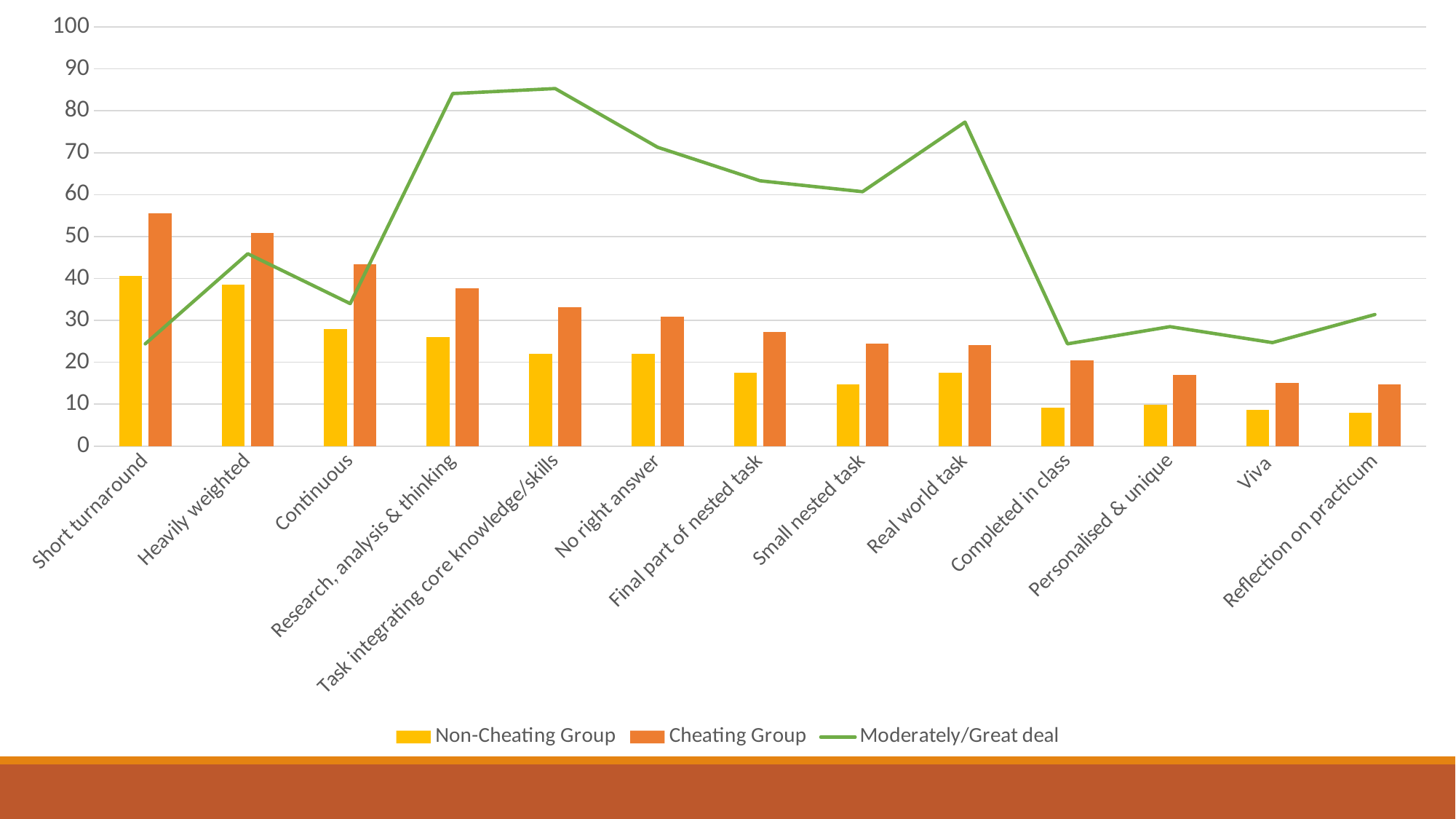
Is the Moderately/Great deal value for Research, analysis & thinking greater or less than 80? greater How many series does the legend list? 3 For Short turnaround, which is larger: the Non-Cheating Group bar or the Cheating Group bar? Cheating Group Which category has the highest value for the Cheating Group? Short turnaround Is the Non-Cheating Group value for Continuous greater or less than 30? less Is the Cheating Group value for Short turnaround greater or less than 50? greater Which series is drawn as a green line? Moderately/Great deal What kind of chart is shown on the slide? A combined bar and line chart Do the Cheating Group bars generally rise or fall from left to right across the categories? fall How many categories are shown along the x axis? 13